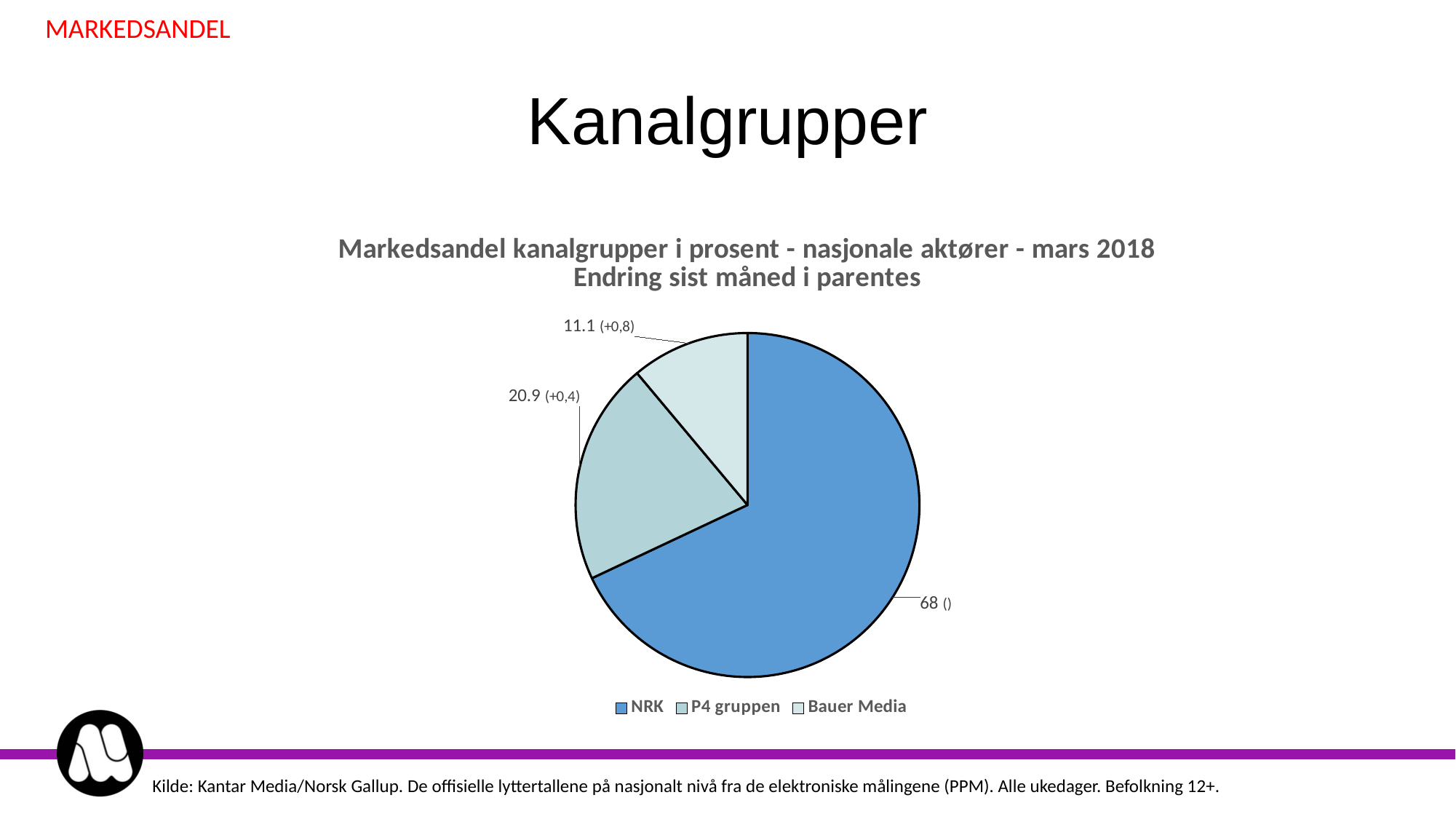
What is the market share value shown for P4 gruppen? 20.9 What is the difference between the values for P4 gruppen and Bauer Media? 9.8 What is the difference between the values for NRK and P4 gruppen? 47.1 What type of chart is shown on the slide? pie chart What change since last month is shown in parentheses for Bauer Media? +0,8 Which channel group has the smallest slice of the pie? Bauer Media What is the market share value shown for Bauer Media? 11.1 How many channel groups does the legend list? 3 Which channel group has the largest slice of the pie? NRK What is the title of the chart? Markedsandel kanalgrupper i prosent - nasjonale aktører - mars 2018 Endring sist måned i parentes What change since last month is shown in parentheses for P4 gruppen? +0,4 What is the market share value shown for NRK? 68